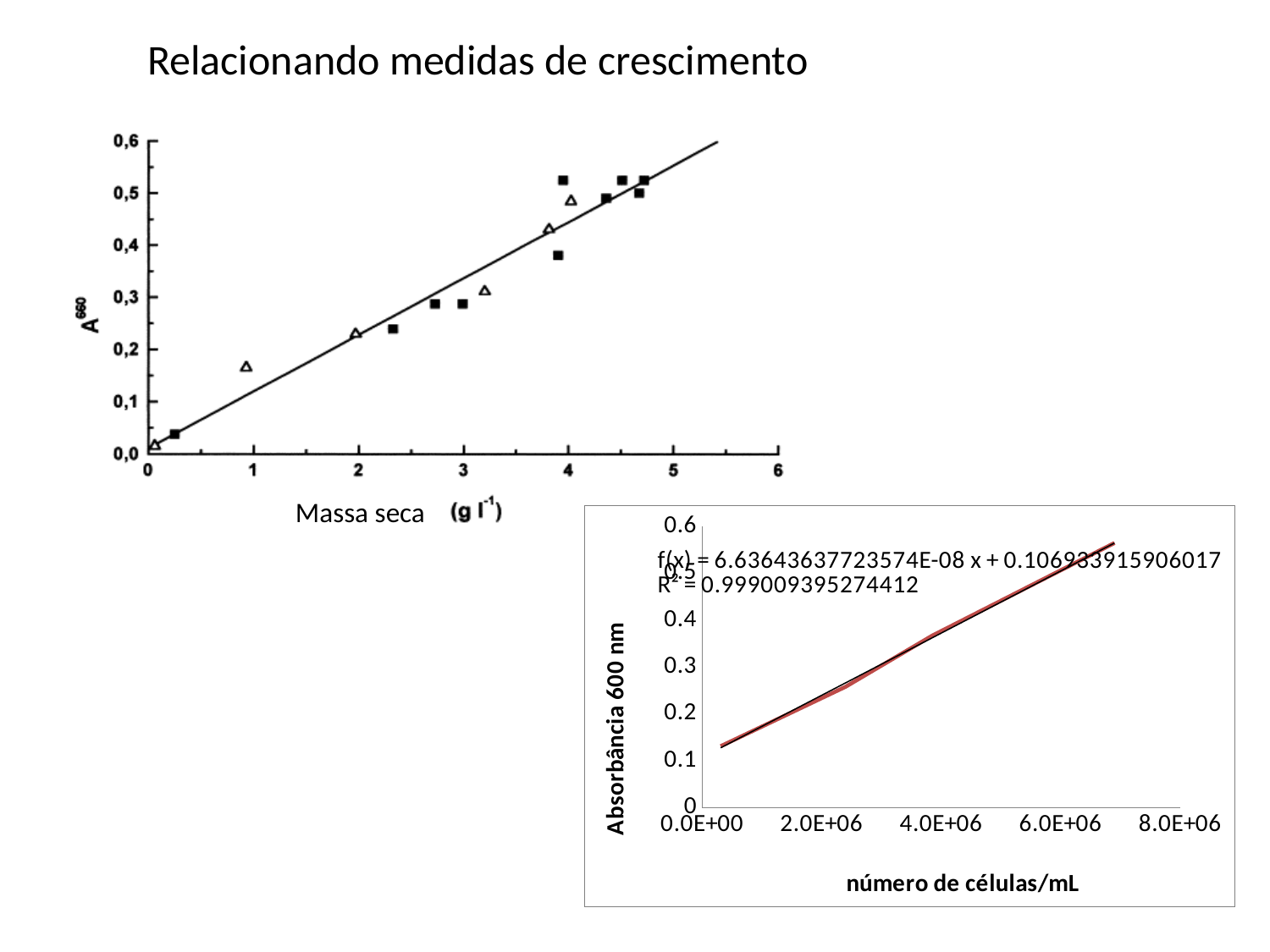
What is the slope of the fitted line f(x) shown on the bottom-right chart? 6.63643637723574E-08 In the bottom-right chart, is the absorbance at 4.0E+06 cells/mL greater or less than 0.3? greater What is the label of the y axis of the bottom-right chart? Absorbância 600 nm What is the R² value shown on the bottom-right chart? 0.999009395274412 What is the highest tick value on the y axis of the top-left chart? 0,6 What is the intercept of the fitted line f(x) shown on the bottom-right chart? 0.106933915906017 In the bottom-right chart, is the absorbance at 2.0E+06 cells/mL greater or less than 0.3? less In the bottom-right chart, does absorbance rise or fall as the number of cells per mL increases? rises What is the label of the x axis of the bottom-right chart? número de células/mL In the top-left chart, does A660 rise or fall as Massa seca increases? rises What kind of chart is the bottom-right chart (Absorbância 600 nm vs número de células/mL)? line chart What kind of chart is the top-left chart (A660 vs Massa seca)? scatter plot